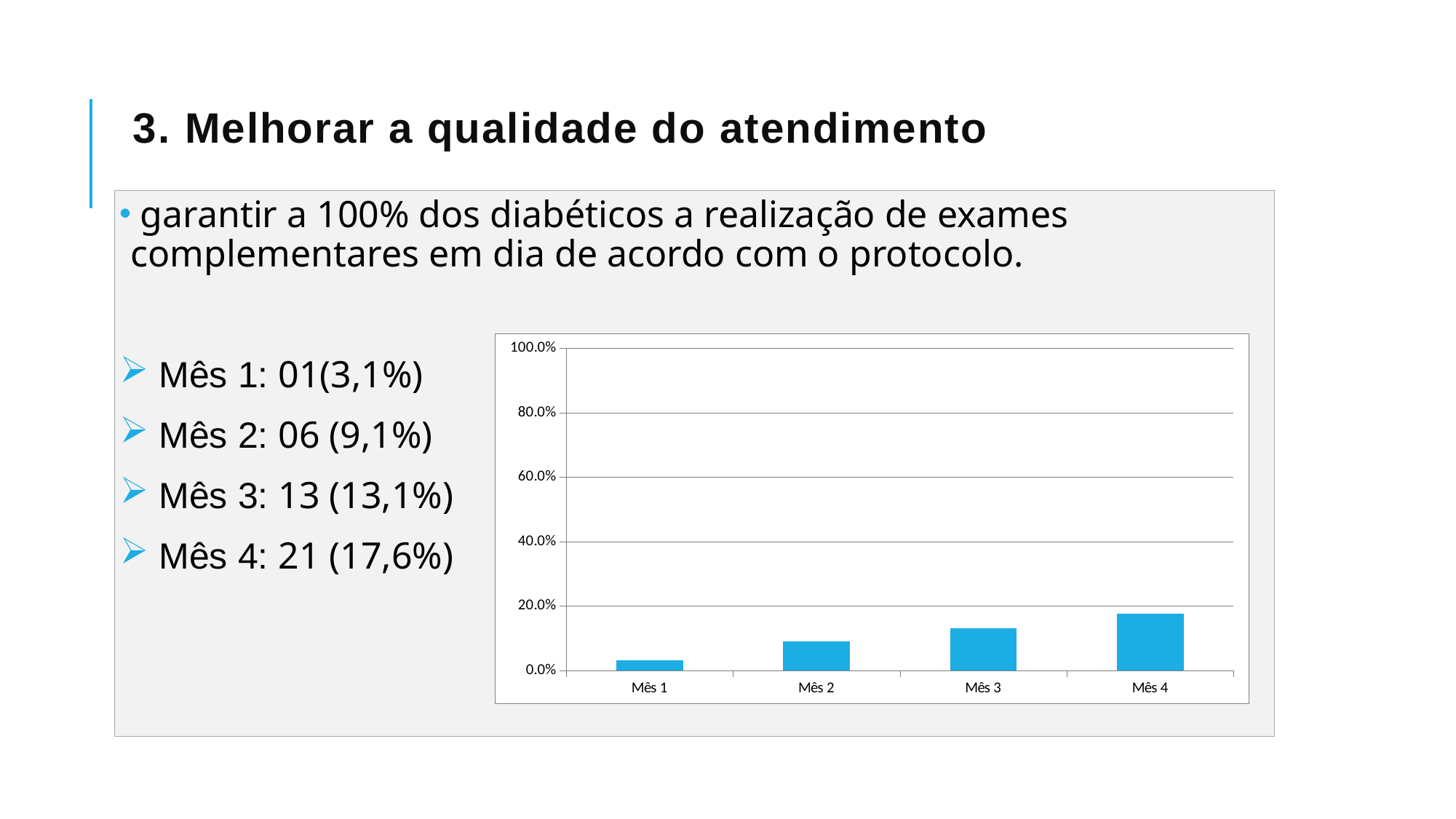
How many categories (months) are plotted on the chart? 4 According to the slide, what percentage is shown for Mês 1? 3,1% What is the label of the third category on the x axis? Mês 3 What is the highest value shown on the chart's vertical axis? 100.0% Which is larger, the bar for Mês 2 or the bar for Mês 3? Mês 3 Is the value for Mês 1 greater or less than 20.0%? less Which month has the lowest bar on the chart? Mês 1 What kind of chart is shown on the slide? bar chart Do the bar values rise or fall from Mês 1 to Mês 4? rise Which month has the highest bar on the chart? Mês 4 Is the value for Mês 4 greater or less than 20.0%? less According to the slide, what percentage is shown for Mês 4? 17,6%